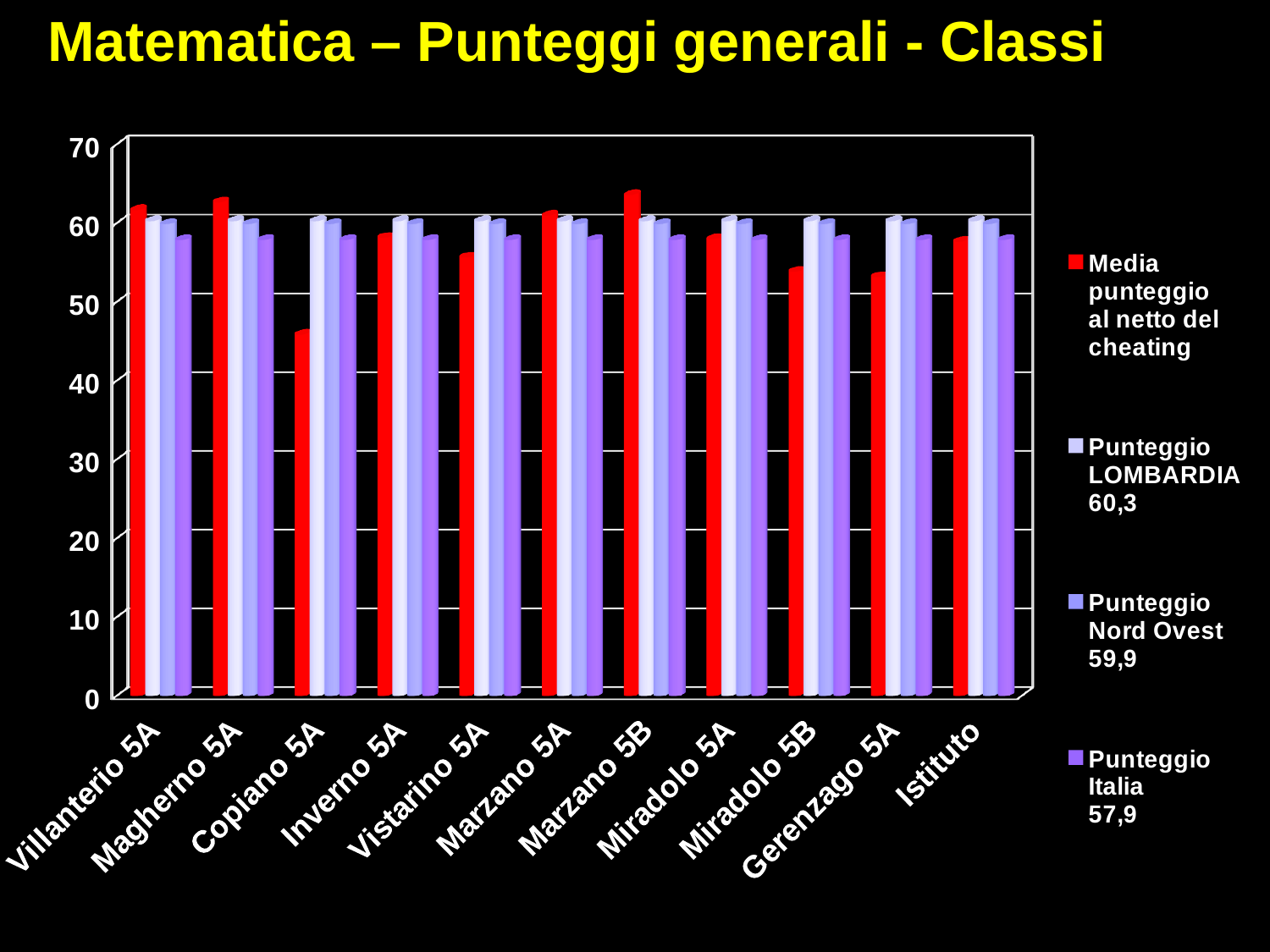
How many series does the legend list? 4 Is the Media punteggio al netto del cheating for Gerenzago 5A greater or less than 60? less What is the difference between Punteggio LOMBARDIA and Punteggio Italia? 2,4 Which class has the lowest Media punteggio al netto del cheating? Copiano 5A Which has a higher Media punteggio al netto del cheating, Magherno 5A or Copiano 5A? Magherno 5A What is the value of Punteggio Italia according to the legend? 57,9 What is the title of the slide? Matematica – Punteggi generali - Classi What kind of chart is shown on the slide? bar chart What is the value of Punteggio LOMBARDIA according to the legend? 60,3 Is the Media punteggio al netto del cheating for Copiano 5A greater or less than 50? less How many categories are shown along the x axis? 11 What is the value of Punteggio Nord Ovest according to the legend? 59,9